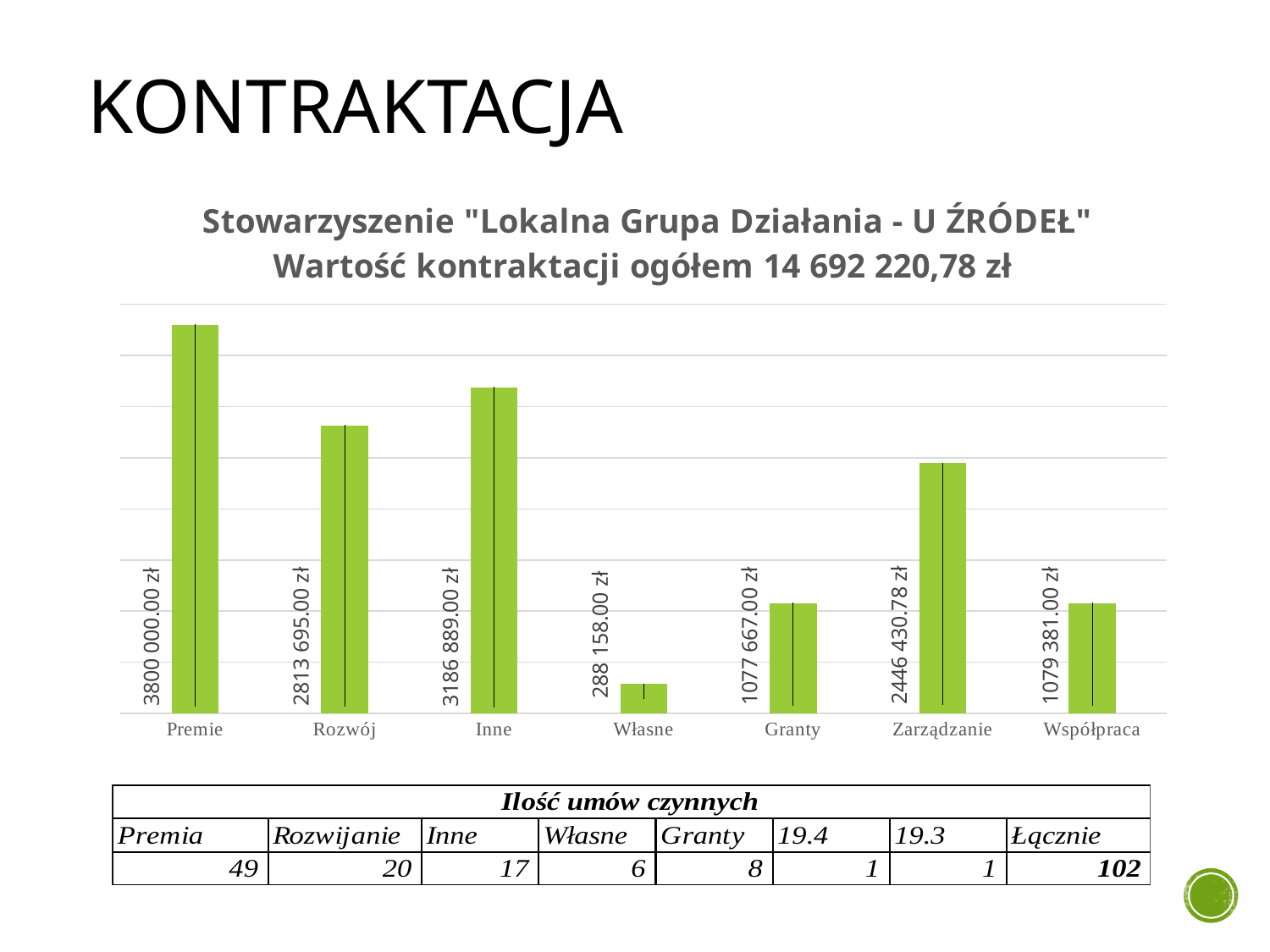
What is the difference between the values for Premie and Rozwój? 986 305.00 zł Which is larger, the value for Inne or the value for Rozwój? Inne What is the value for Własne? 288 158.00 zł How many categories are shown on the chart? 7 What kind of chart is shown on the slide? Bar chart Which category has the lowest value? Własne What total contract value is stated in the chart title? 14 692 220,78 zł Which category has the highest value? Premie What is the difference between the values for Inne and Granty? 2109 222.00 zł What is the value for Granty? 1077 667.00 zł What is the value for Premie? 3800 000.00 zł What is the value for Zarządzanie? 2446 430.78 zł